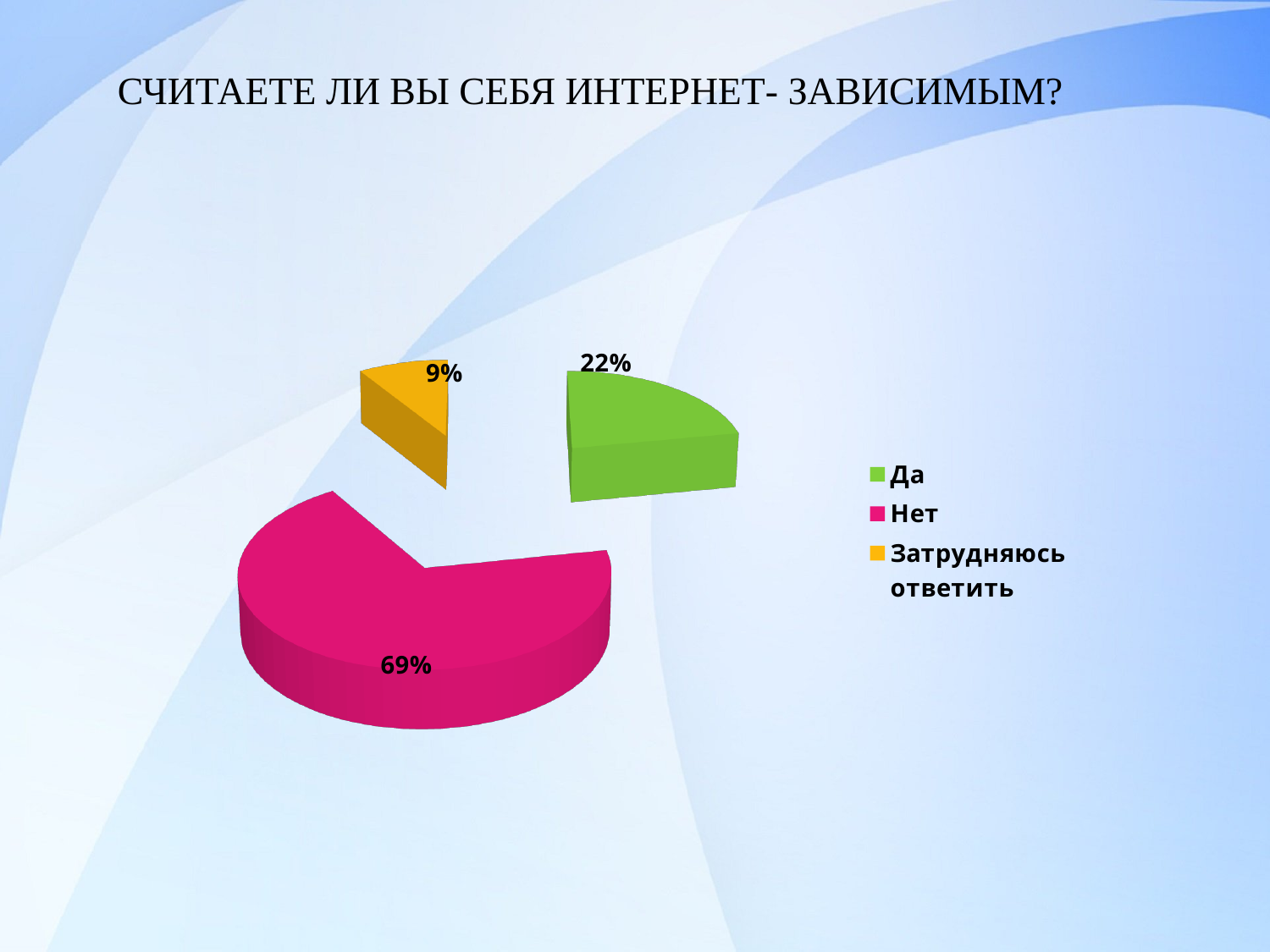
What colour is the slice for "Нет"? Pink Which category has the largest slice of the pie? Нет Which is larger, the share for "Да" or the share for "Затрудняюсь ответить"? Да What share of the pie does "Затрудняюсь ответить" represent? 9% What kind of chart is shown on the slide? Pie chart Which category has the smallest slice of the pie? Затрудняюсь ответить What is the difference in percentage points between "Нет" and "Да"? 47% What is the title of the slide above the chart? СЧИТАЕТЕ ЛИ ВЫ СЕБЯ ИНТЕРНЕТ- ЗАВИСИМЫМ? What is the difference in percentage points between "Да" and "Затрудняюсь ответить"? 13% What share of the pie does "Нет" represent? 69% How many categories does the pie chart have? 3 What share of the pie does "Да" represent? 22%